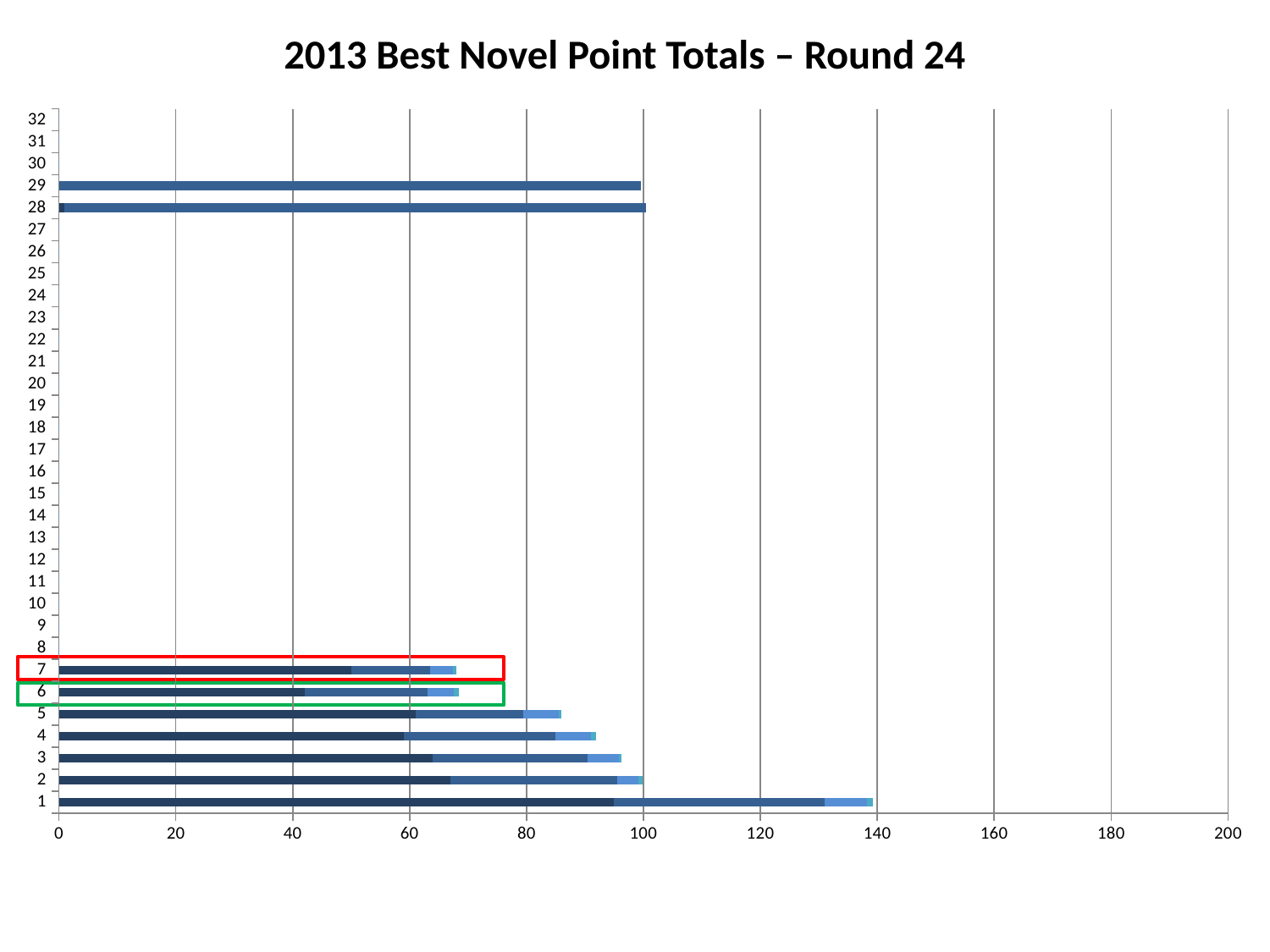
Is the total for category 5 greater or less than 80? greater Is the total for category 3 greater or less than 100? less What is the title of the chart? 2013 Best Novel Point Totals – Round 24 Which category is outlined with a red box on the chart? 7 Is the total for category 7 greater or less than 80? less What kind of chart is shown on the slide? bar chart How many categories are listed on the vertical axis? 32 Which category has the highest total? 1 Which has the larger total, category 1 or category 28? 1 Which has the larger total, category 5 or category 7? 5